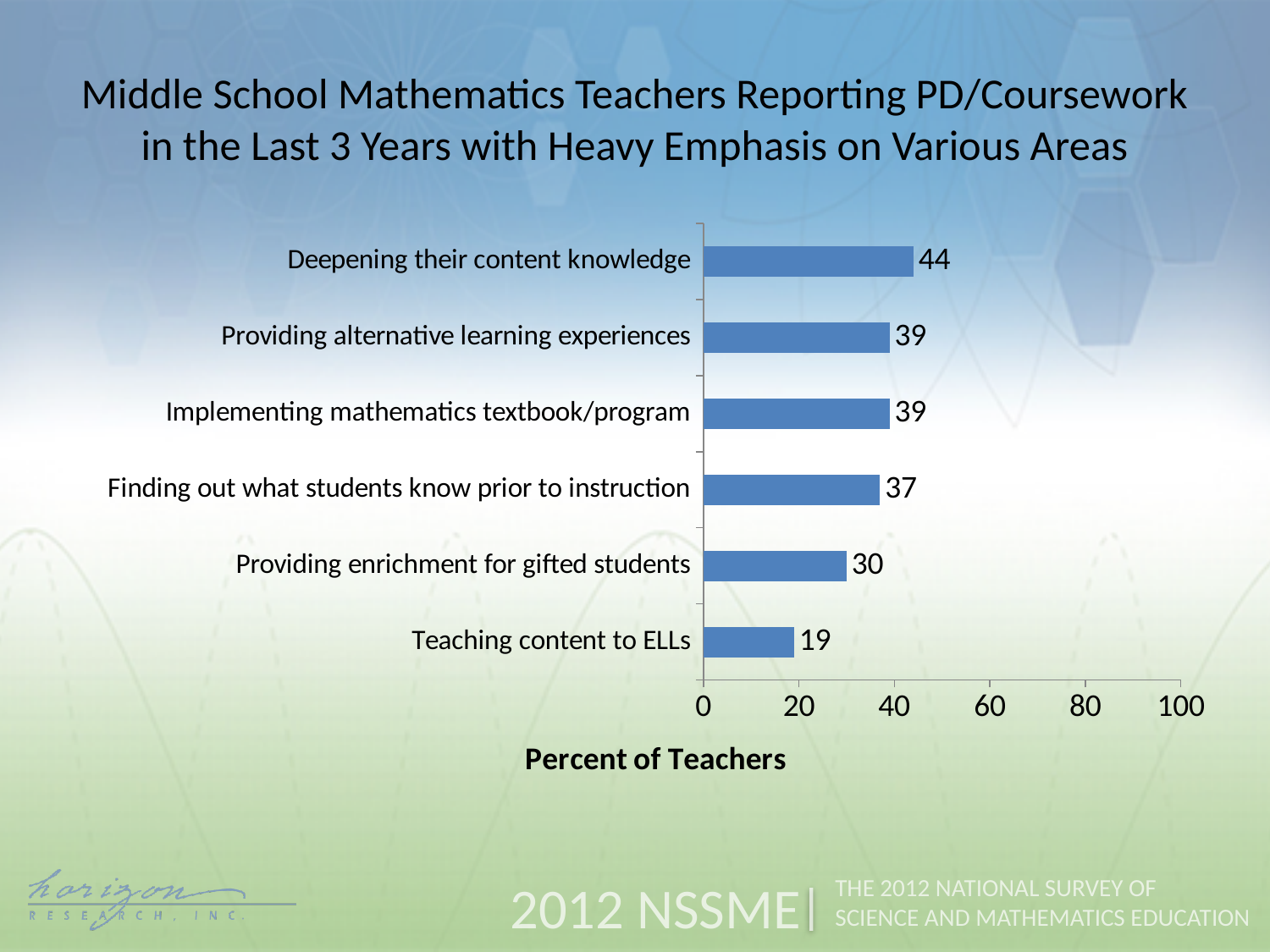
Is the value for Providing alternative learning experiences greater or less than 20? greater What is the value for Finding out what students know prior to instruction? 37 What is the label of the horizontal axis? Percent of Teachers What kind of chart is shown on the slide? Bar chart Which is larger: the value for Providing enrichment for gifted students or the value for Finding out what students know prior to instruction? Finding out what students know prior to instruction What is the value for Teaching content to ELLs? 19 How many areas are shown in the chart? 6 Which area has the highest percent of teachers? Deepening their content knowledge What is the value for Providing enrichment for gifted students? 30 Which area has the lowest percent of teachers? Teaching content to ELLs What is the difference between the values for Deepening their content knowledge and Teaching content to ELLs? 25 What percent of teachers reported PD/coursework with heavy emphasis on deepening their content knowledge? 44